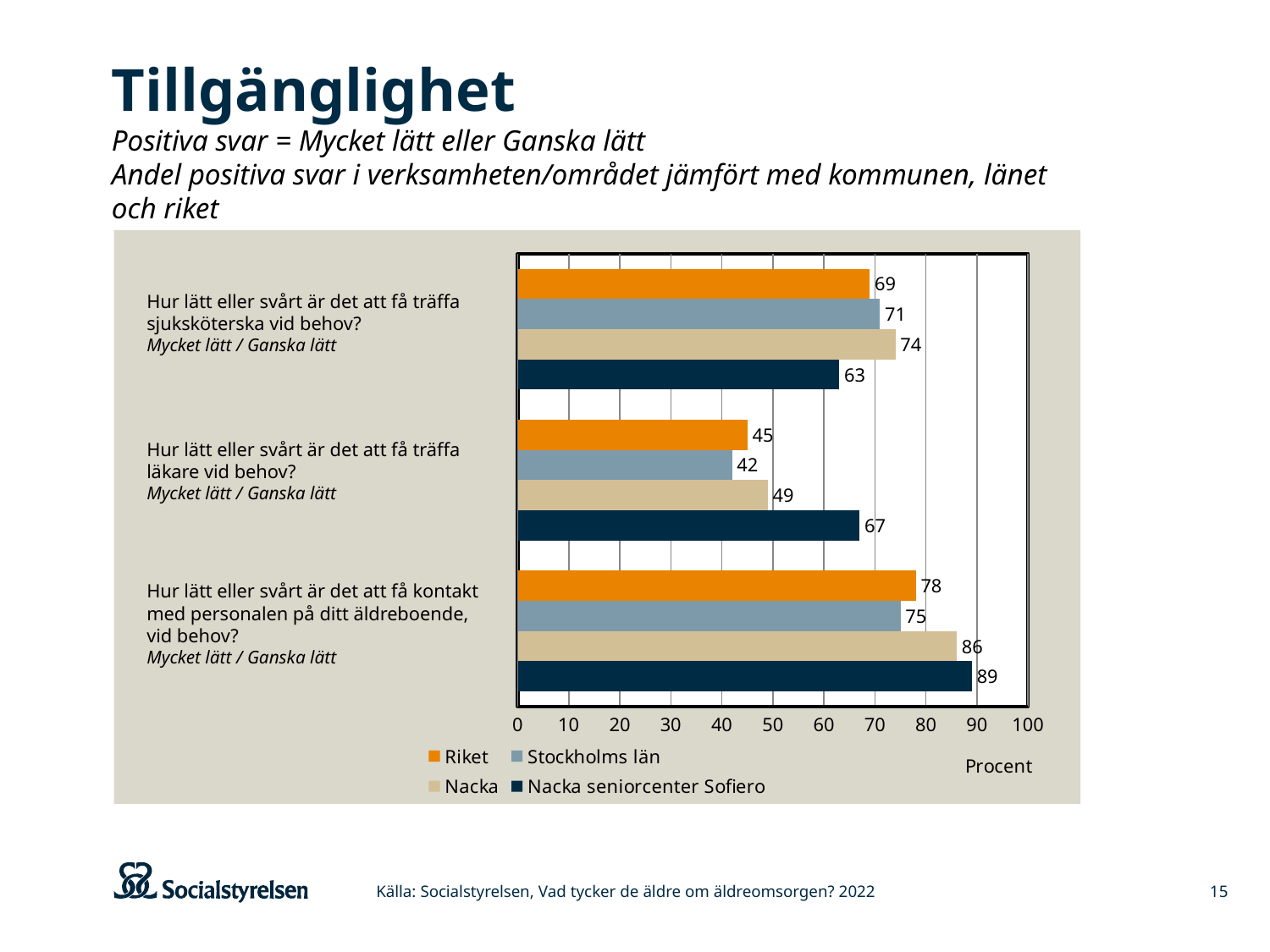
What is the value for Stockholms län for the question about meeting a nurse when needed ("få träffa sjuksköterska vid behov")? 71 What is the value for Nacka seniorcenter Sofiero for the question about getting in contact with staff at the care home ("få kontakt med personalen på ditt äldreboende")? 89 Which series has the lowest value for the question about meeting a doctor when needed ("få träffa läkare vid behov")? Stockholms län What label is shown on the horizontal axis of the chart? Procent What kind of chart is shown on the slide? bar chart How many question categories are plotted in the chart? 3 How many series does the legend list? 4 What is the difference between Nacka seniorcenter Sofiero and Riket for the question about meeting a doctor when needed ("få träffa läkare vid behov")? 22 What is the difference between Nacka and Nacka seniorcenter Sofiero for the question about meeting a nurse when needed ("få träffa sjuksköterska vid behov")? 11 What is the value for Riket for the question about meeting a doctor when needed ("få träffa läkare vid behov")? 45 Which series has the highest value for the question about meeting a nurse when needed ("få träffa sjuksköterska vid behov")? Nacka For the question about getting in contact with staff at the care home, which is larger: the value for Nacka or the value for Stockholms län? Nacka